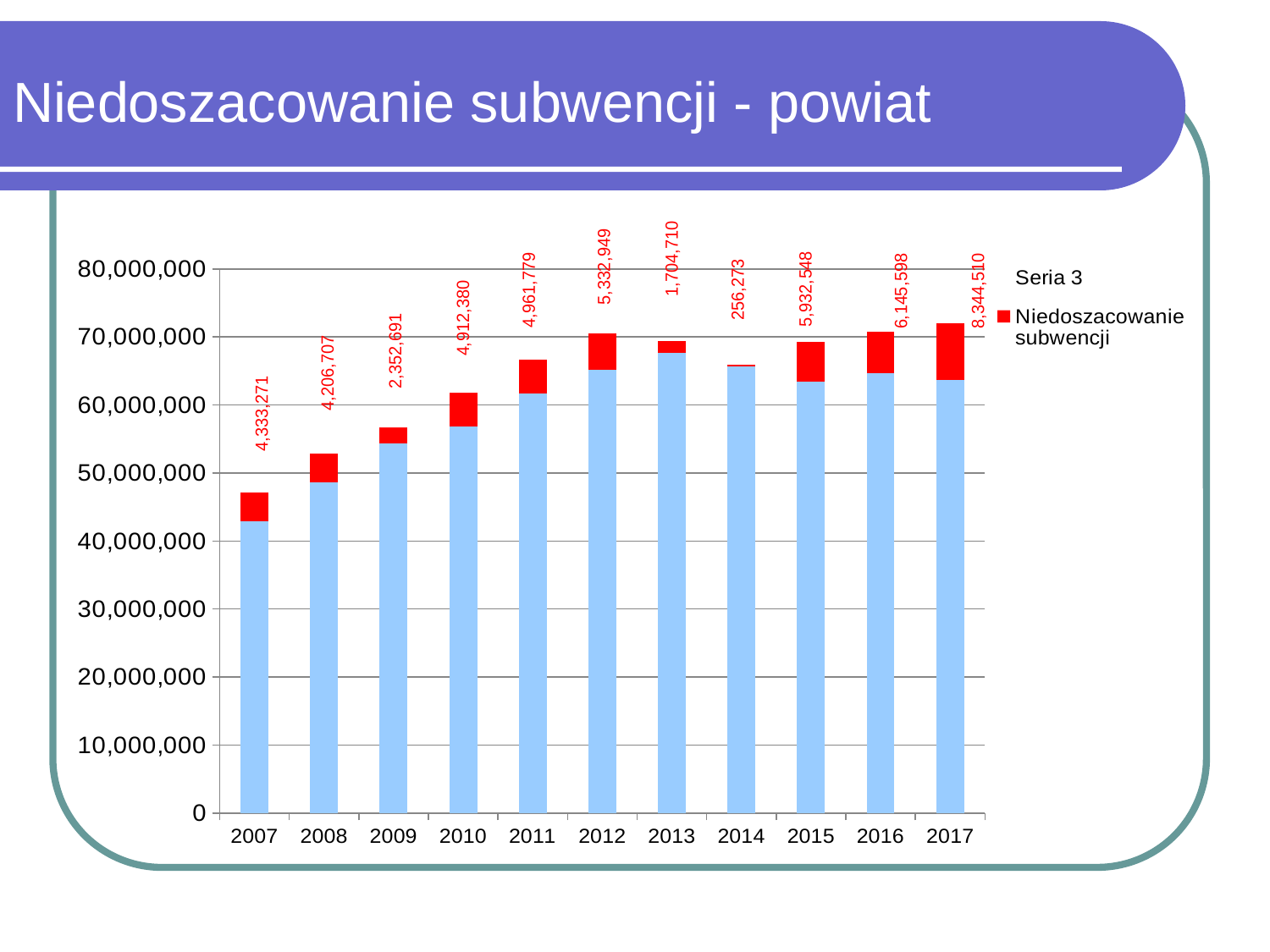
What is the value of Niedoszacowanie subwencji for 2017? 8,344,510 What is the value of Niedoszacowanie subwencji for 2009? 2,352,691 Is the total height of the 2007 bar greater or less than 50,000,000? less How many series does the legend list? 2 Which is larger, the Niedoszacowanie subwencji value for 2012 or for 2013? 2012 Is the total height of the 2017 bar greater or less than 70,000,000? greater How many years are shown on the x axis? 11 What kind of chart is shown on the slide? Stacked bar chart What is the value of Niedoszacowanie subwencji for 2014? 256,273 What is the difference between the Niedoszacowanie subwencji values for 2017 and 2016? 2,198,912 Which year has the highest value of Niedoszacowanie subwencji? 2017 Which year has the lowest value of Niedoszacowanie subwencji? 2014